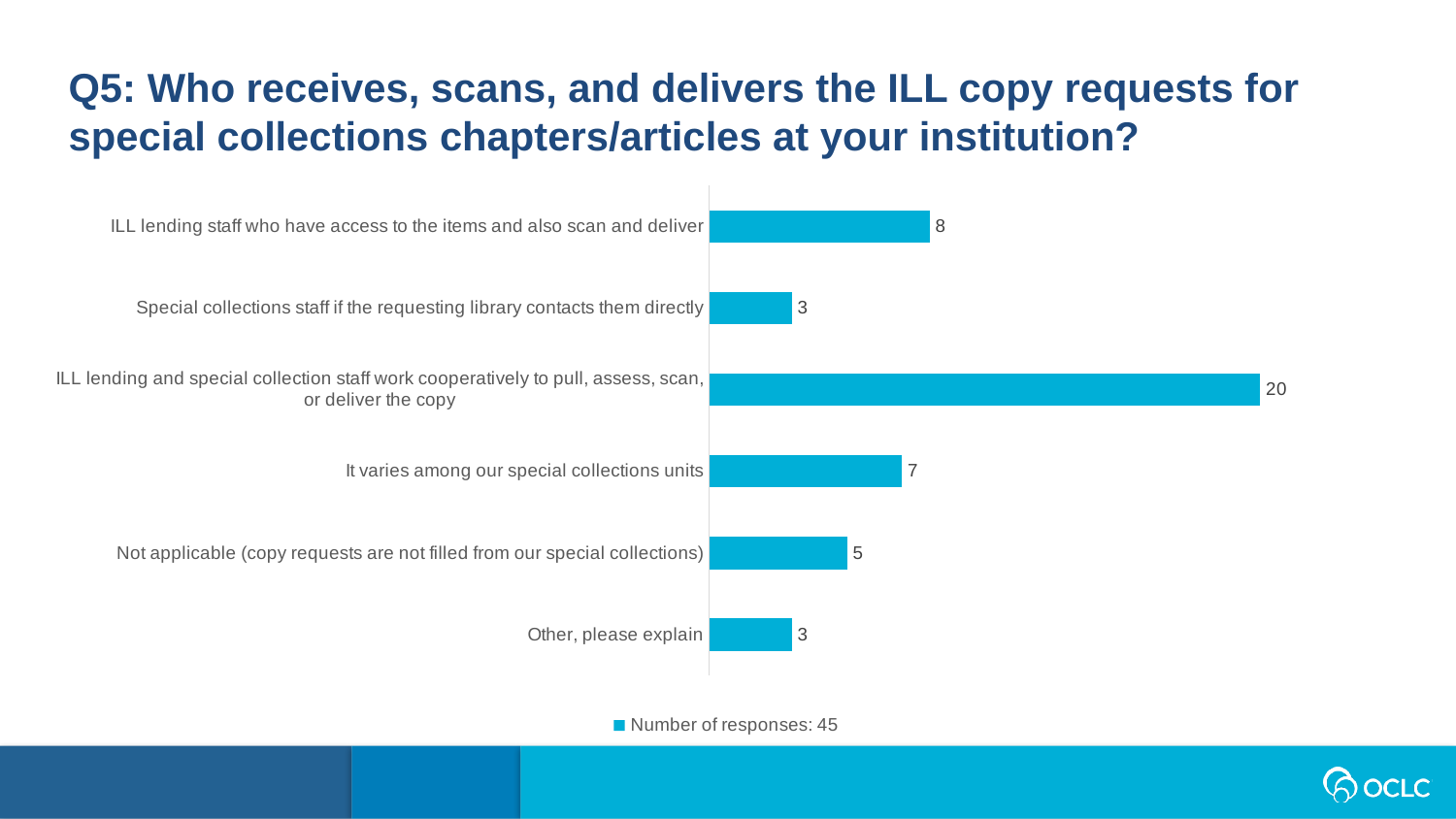
How many categories are shown in the chart? 6 What is the value for "Not applicable (copy requests are not filled from our special collections)"? 5 Which category has the highest value? ILL lending and special collection staff work cooperatively to pull, assess, scan, or deliver the copy What is the difference between the value for "ILL lending and special collection staff work cooperatively to pull, assess, scan, or deliver the copy" and the value for "ILL lending staff who have access to the items and also scan and deliver"? 12 What is the value for "ILL lending staff who have access to the items and also scan and deliver"? 8 How many series does the legend list? 1 Which is larger: the value for "It varies among our special collections units" or the value for "Not applicable (copy requests are not filled from our special collections)"? It varies among our special collections units What is the difference between the value for "Special collections staff if the requesting library contacts them directly" and the value for "Other, please explain"? 0 What is the legend entry shown below the chart? Number of responses: 45 What is the value for "It varies among our special collections units"? 7 What is the value for "ILL lending and special collection staff work cooperatively to pull, assess, scan, or deliver the copy"? 20 What kind of chart is shown on the slide? Bar chart